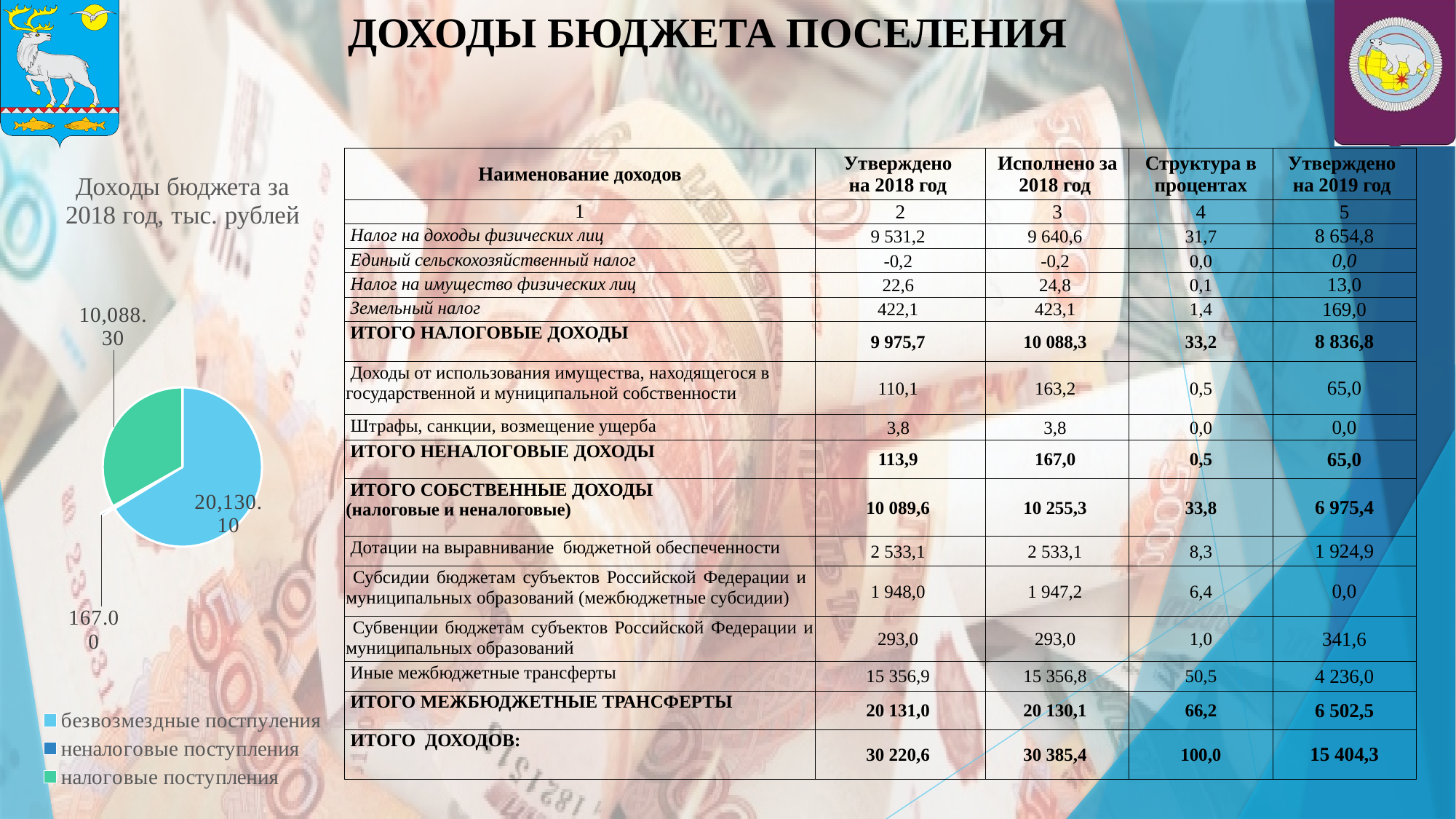
What kind of chart is shown on the left of the slide? pie chart What is the title of the pie chart? Доходы бюджета за 2018 год, тыс. рублей In the pie chart, which is larger: налоговые поступления or неналоговые поступления? налоговые поступления How many entries does the pie chart's legend list? 3 How many slices does the pie chart have? 3 What is the value shown for налоговые поступления in the pie chart? 10,088.30 What is the value shown for неналоговые поступления in the pie chart? 167.00 What is the difference between безвозмездные поступления and налоговые поступления in the pie chart? 10,041.80 Which category has the smallest slice in the pie chart? неналоговые поступления Which category has the largest slice in the pie chart? безвозмездные поступления What colour is the безвозмездные поступления slice in the pie chart? light blue What is the value shown for безвозмездные поступления in the pie chart? 20,130.10